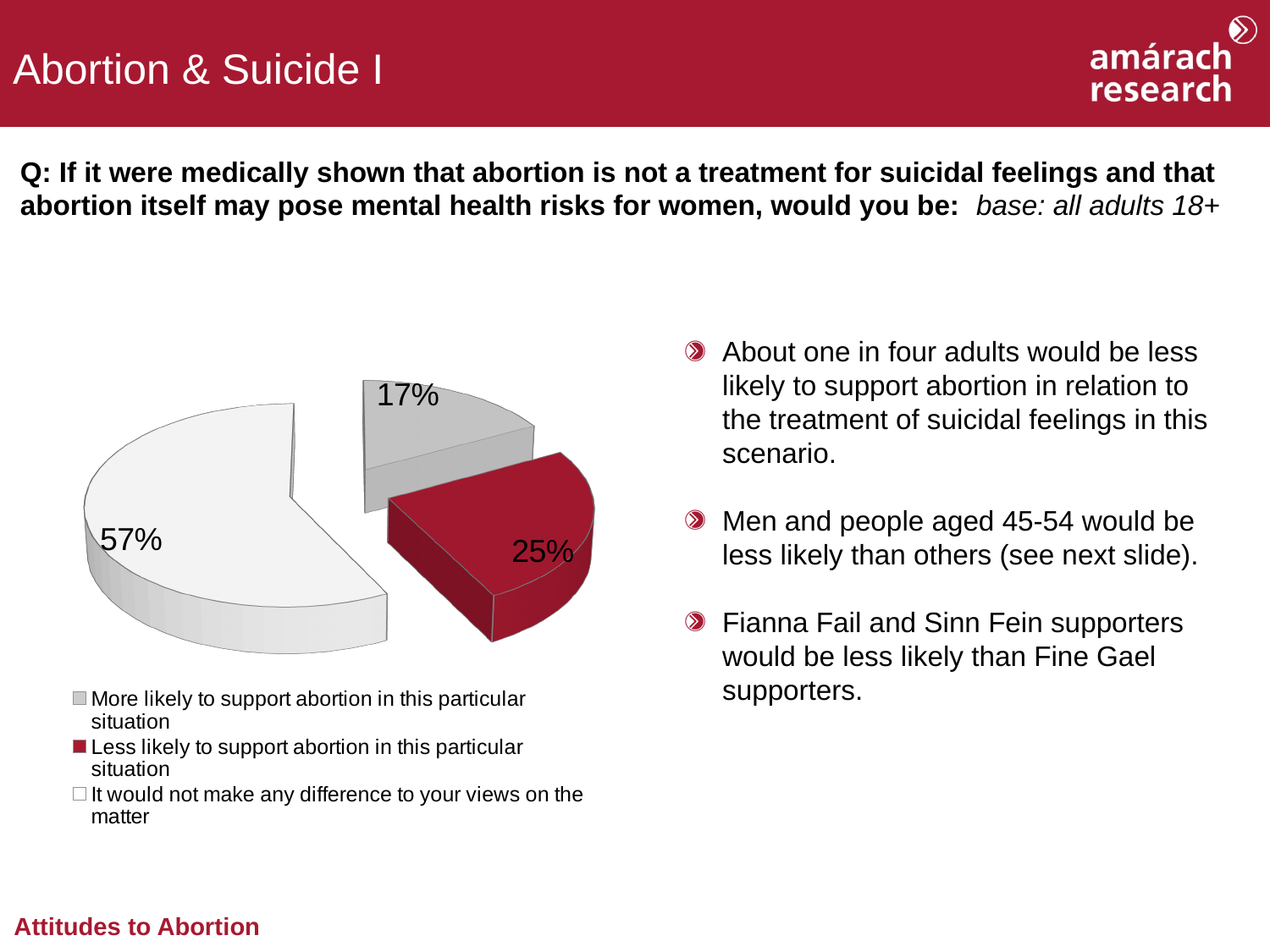
Which response has the smallest share of the pie? More likely to support abortion in this particular situation How many entries does the legend list? 3 What percentage of adults said it would not make any difference to their views on the matter? 57% What is the difference in percentage points between 'Less likely' and 'More likely' to support abortion? 8 What is the difference in percentage points between 'It would not make any difference' and 'Less likely to support abortion'? 32 What kind of chart is shown on the slide? Pie chart How many slices does the pie chart have? 3 What percentage of adults said they would be more likely to support abortion in this particular situation? 17% Which response has the largest share of the pie? It would not make any difference to your views on the matter What percentage of adults said they would be less likely to support abortion in this particular situation? 25% What colour is the slice for 'Less likely to support abortion in this particular situation'? Red Which is larger: the share for 'More likely to support abortion' or 'Less likely to support abortion'? Less likely to support abortion in this particular situation